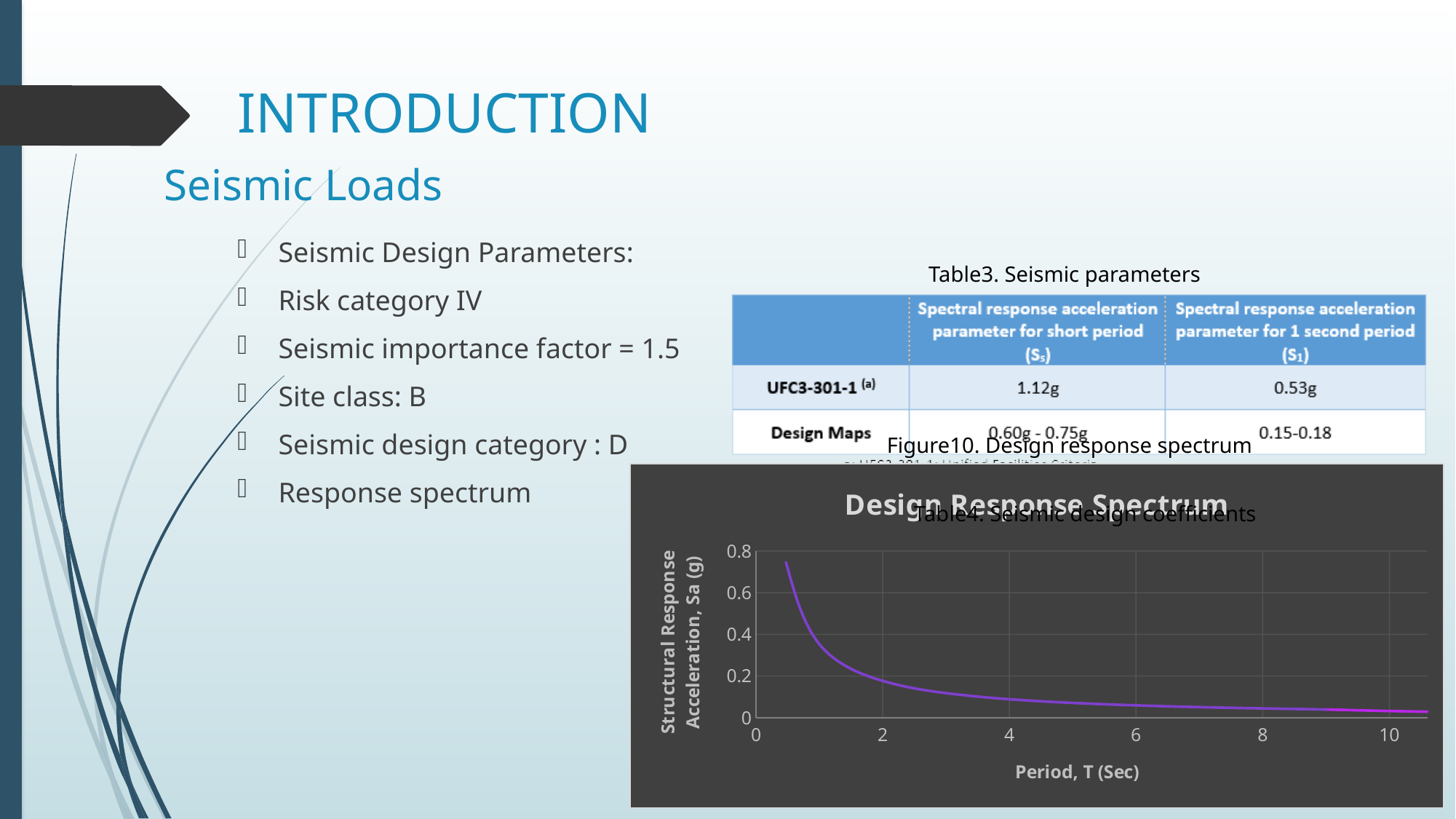
In the Design Response Spectrum chart, is the value at a period of 8 seconds greater or less than 0.2? less What kind of chart is the Design Response Spectrum chart? line chart What is the title of the chart on the slide? Design Response Spectrum What is the x-axis label of the Design Response Spectrum chart? Period, T (Sec) How many lines are plotted in the Design Response Spectrum chart? 1 In the Design Response Spectrum chart, does the structural response acceleration rise or fall as the period increases? fall In the Design Response Spectrum chart, is the value at a period of 1 second larger or smaller than the value at a period of 6 seconds? larger What is the highest tick value shown on the y-axis of the Design Response Spectrum chart? 0.8 In the Design Response Spectrum chart, is the highest value of the curve greater or less than 0.6? greater In the Design Response Spectrum chart, is the value at a period of 2 seconds greater or less than 0.4? less